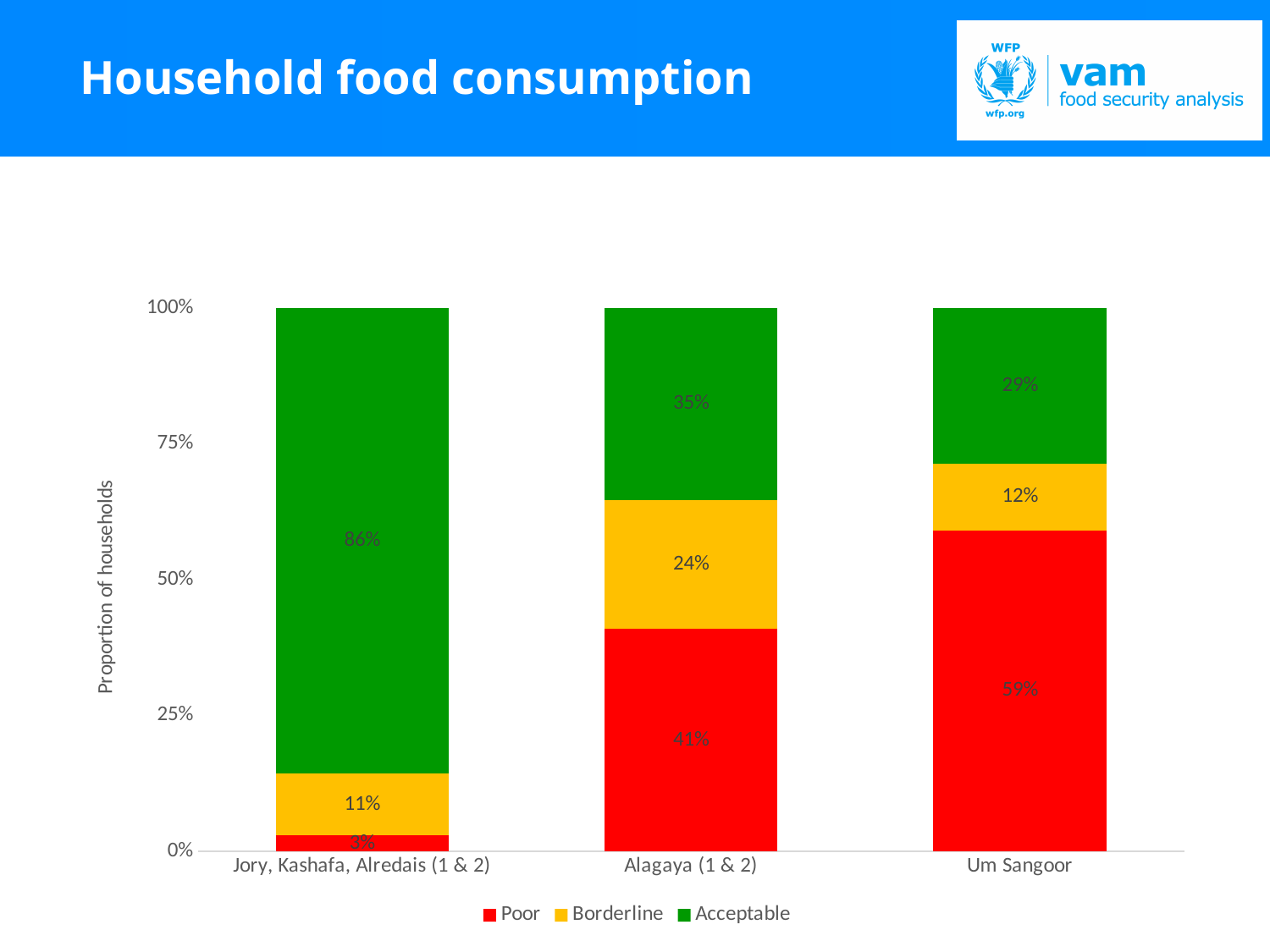
Which location has the highest Poor share? Um Sangoor Which location has the lowest Acceptable share? Um Sangoor How many locations are shown on the x axis? 3 What is the Acceptable share for Jory, Kashafa, Alredais (1 & 2)? 86% What is the difference between the Poor shares of Um Sangoor and Alagaya (1 & 2)? 18% What percentage of households in Um Sangoor have Poor food consumption? 59% Which is larger: the Borderline share for Alagaya (1 & 2) or for Um Sangoor? Alagaya (1 & 2) What is the Poor value for Jory, Kashafa, Alredais (1 & 2)? 3% How many series does the legend list? 3 What kind of chart is shown on the slide? Stacked bar chart What is the Borderline value for Alagaya (1 & 2)? 24% What is the label of the y axis? Proportion of households